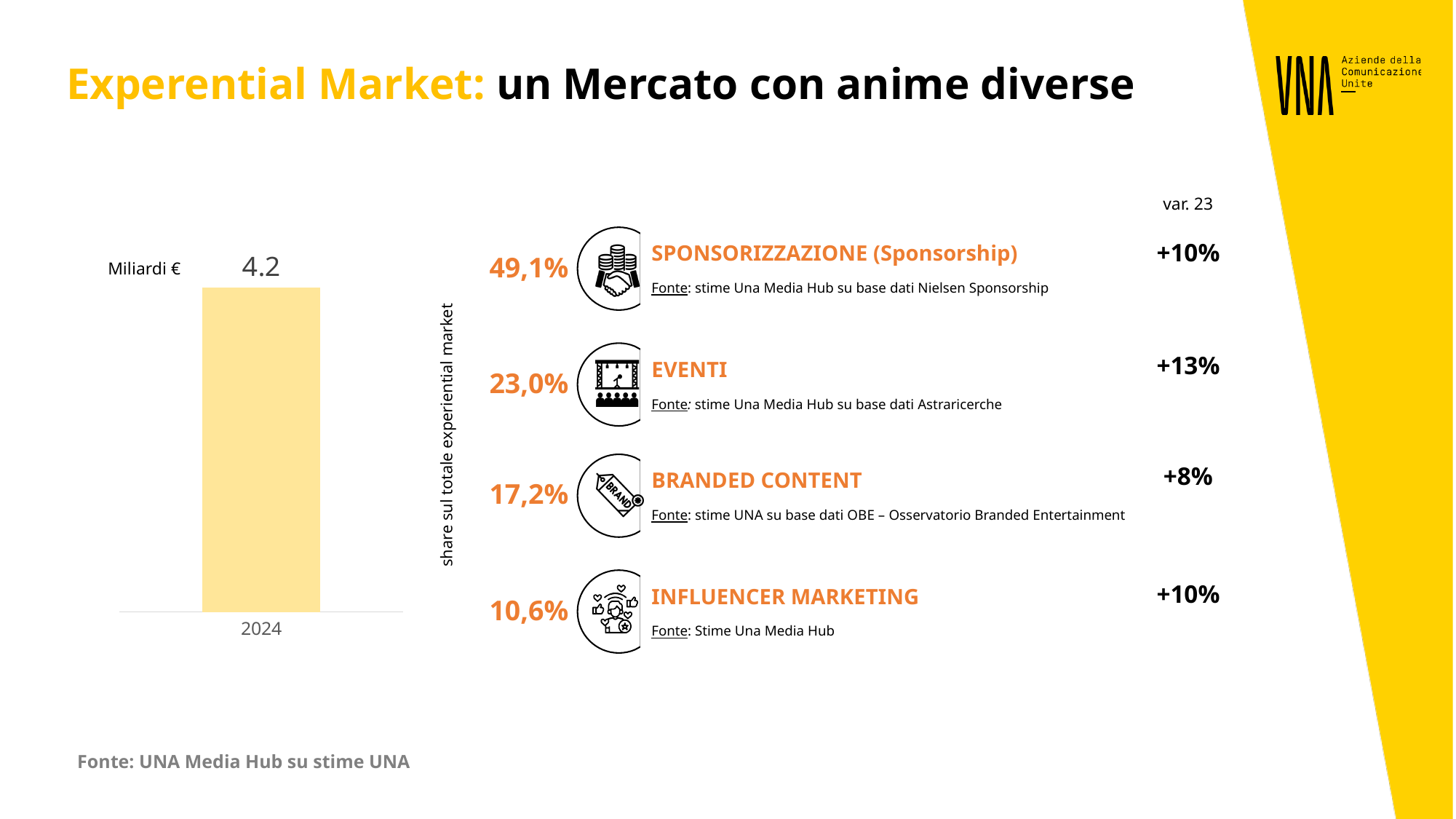
In the share breakdown on the right, what is the var. 23 value for BRANDED CONTENT? +8% In the share breakdown on the right, what is the share for EVENTI? 23,0% What kind of chart is shown on the left of the slide? bar chart What unit is indicated next to the bar chart on the left? Miliardi € In the share breakdown on the right, which segment has the highest share of the experiential market? SPONSORIZZAZIONE (Sponsorship) In the share breakdown on the right, what is the share for SPONSORIZZAZIONE (Sponsorship)? 49,1% In the bar chart on the left, what is the value for 2024? 4.2 In the share breakdown on the right, which segment has the lowest share of the experiential market? INFLUENCER MARKETING How many bars does the bar chart on the left show? 1 What is the category label on the x axis of the bar chart on the left? 2024 In the share breakdown on the right, what is the share for INFLUENCER MARKETING? 10,6% In the share breakdown on the right, which segment has the largest var. 23 value? EVENTI